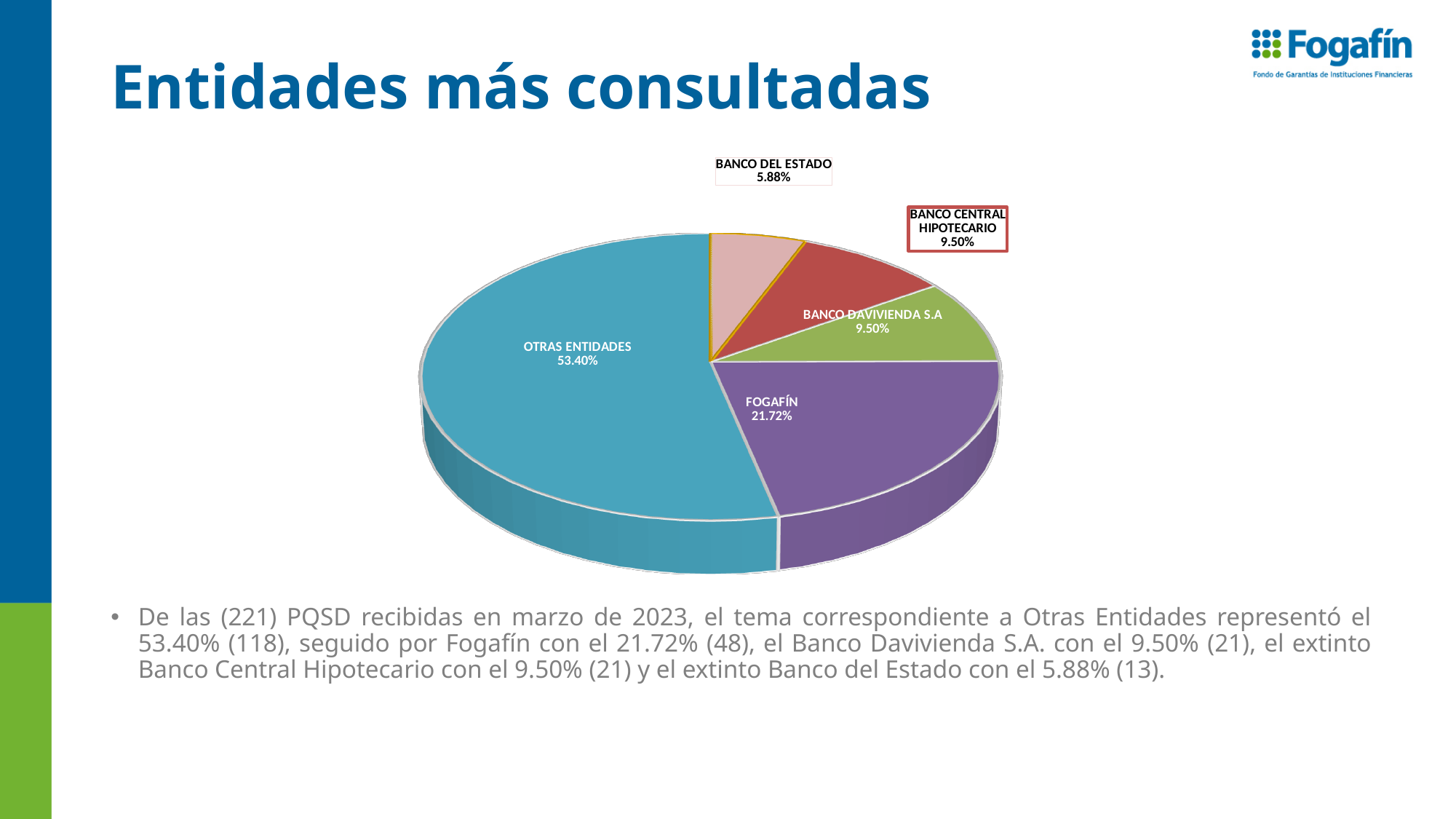
Which is larger, the share for FOGAFÍN or the share for BANCO DAVIVIENDA S.A? FOGAFÍN Which category has the largest slice of the pie? OTRAS ENTIDADES What is the difference between the shares of OTRAS ENTIDADES and FOGAFÍN? 31.68% What is the difference between the shares of FOGAFÍN and BANCO DAVIVIENDA S.A? 12.22% What share of the pie does OTRAS ENTIDADES represent? 53.40% What is the title of the slide containing the chart? Entidades más consultadas What kind of chart is shown on the slide? Pie chart Which category has the smallest slice of the pie? BANCO DEL ESTADO What percentage is shown for BANCO DEL ESTADO? 5.88% What is the value for BANCO CENTRAL HIPOTECARIO? 9.50% How many slices does the pie chart have? 5 What is the value shown for FOGAFÍN? 21.72%